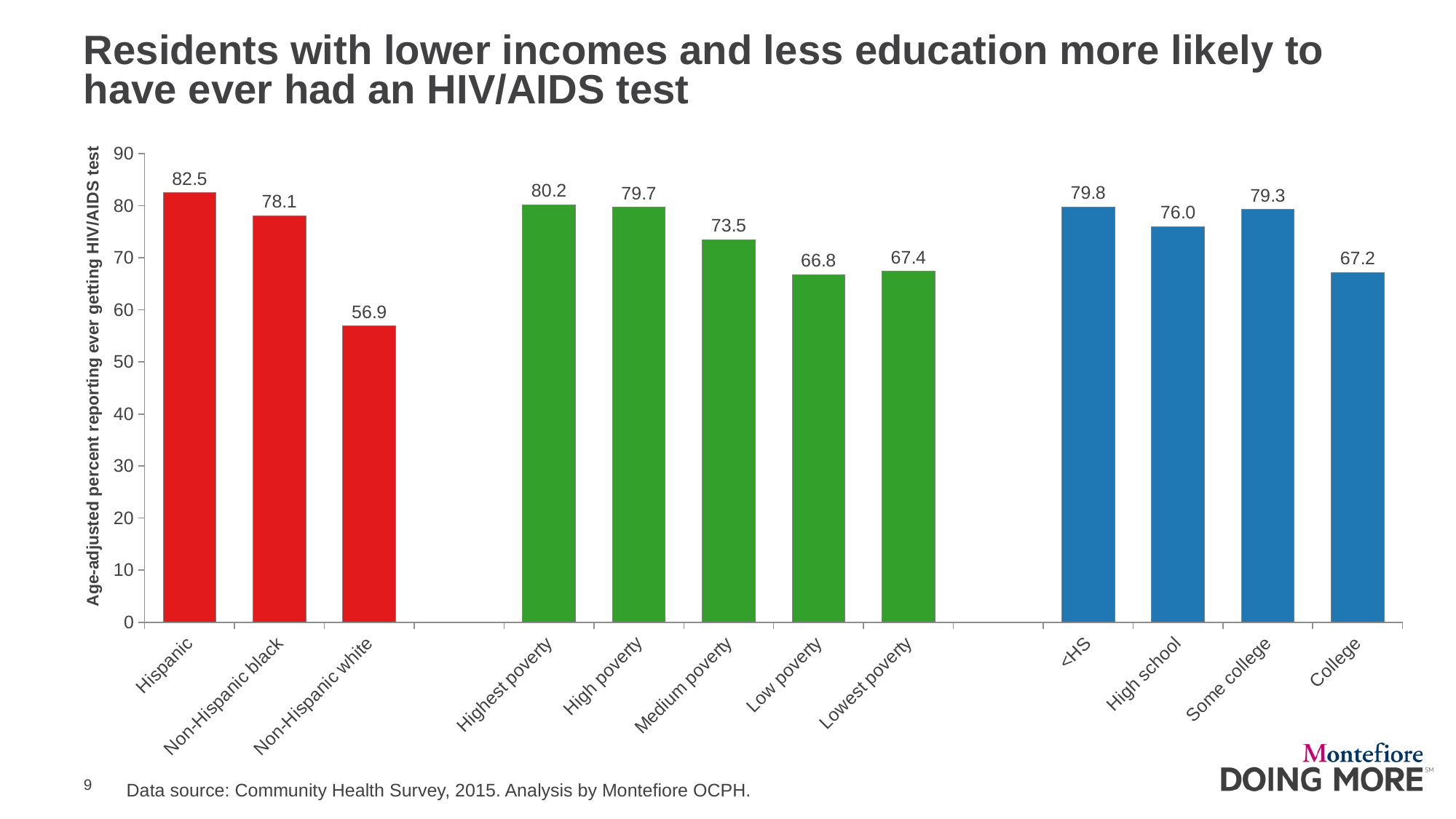
Which category has the highest value? Hispanic What is the difference between the values for Hispanic and Non-Hispanic white? 25.6 What is the value for College? 67.2 What is the value for Non-Hispanic white? 56.9 What is the value for Hispanic? 82.5 Which is larger, the value for Highest poverty or the value for Lowest poverty? Highest poverty What is the difference between the values for <HS and College? 12.6 What kind of chart is this? Bar chart What is the value for Medium poverty? 73.5 How many categories are shown on the x axis? 12 Which category has the lowest value? Non-Hispanic white What is the y-axis label of the chart? Age-adjusted percent reporting ever getting HIV/AIDS test